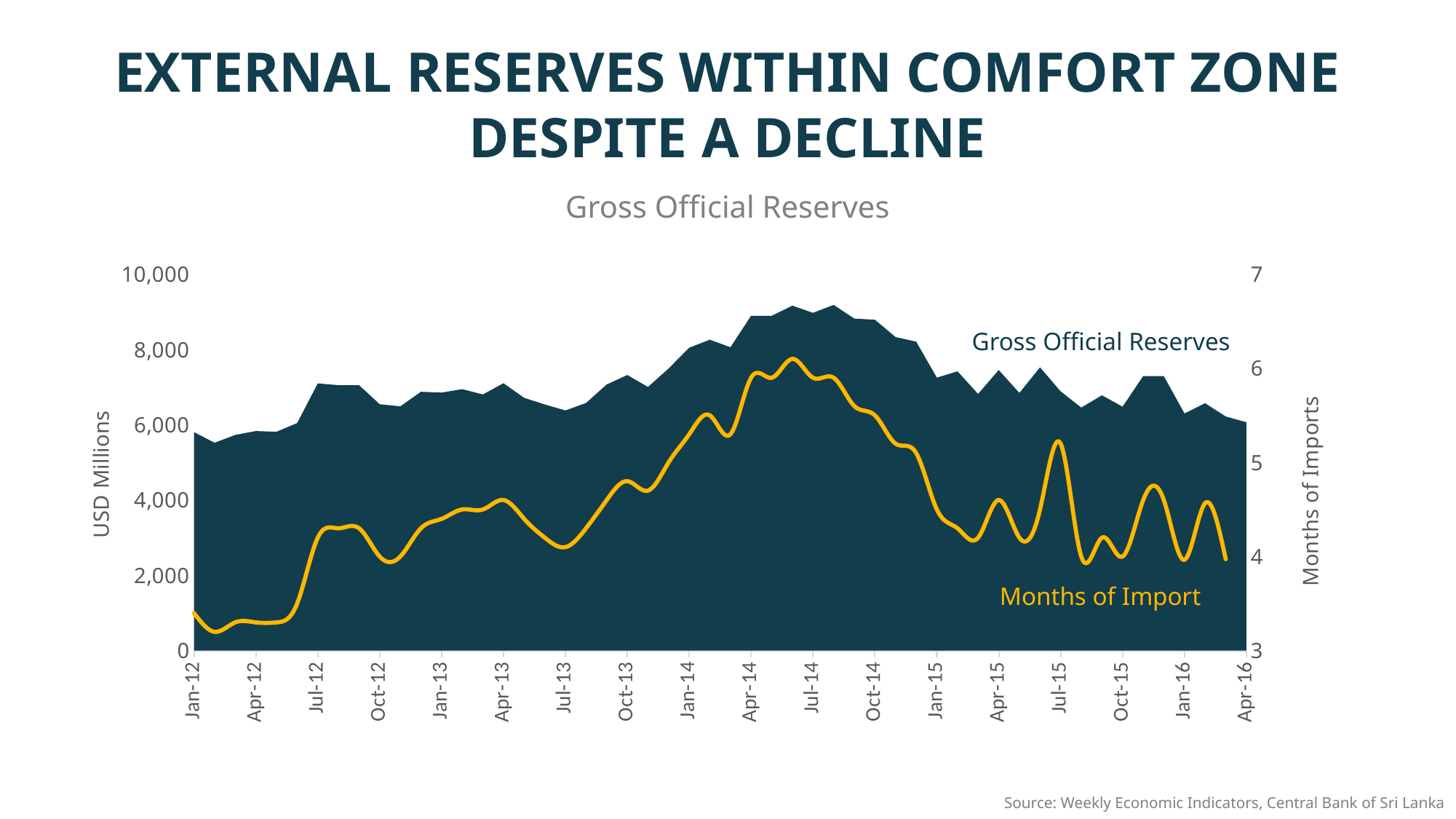
Is the Months of Import value at Jan-12 greater or less than 4? less Is the peak Months of Import value in mid-2014 greater or less than 5? greater How many data series are plotted on the chart? 2 Does Gross Official Reserves rise or fall between Jul-14 and Apr-16? fall Is the value of Gross Official Reserves at Jan-15 greater or less than 6,000 USD Millions? greater What is the title of the chart? Gross Official Reserves What kind of chart is shown on the slide? Area chart with a line overlay How many tick labels are shown on the x axis? 18 In which year does Gross Official Reserves reach its highest level? 2014 What is the label of the right-hand vertical axis? Months of Imports